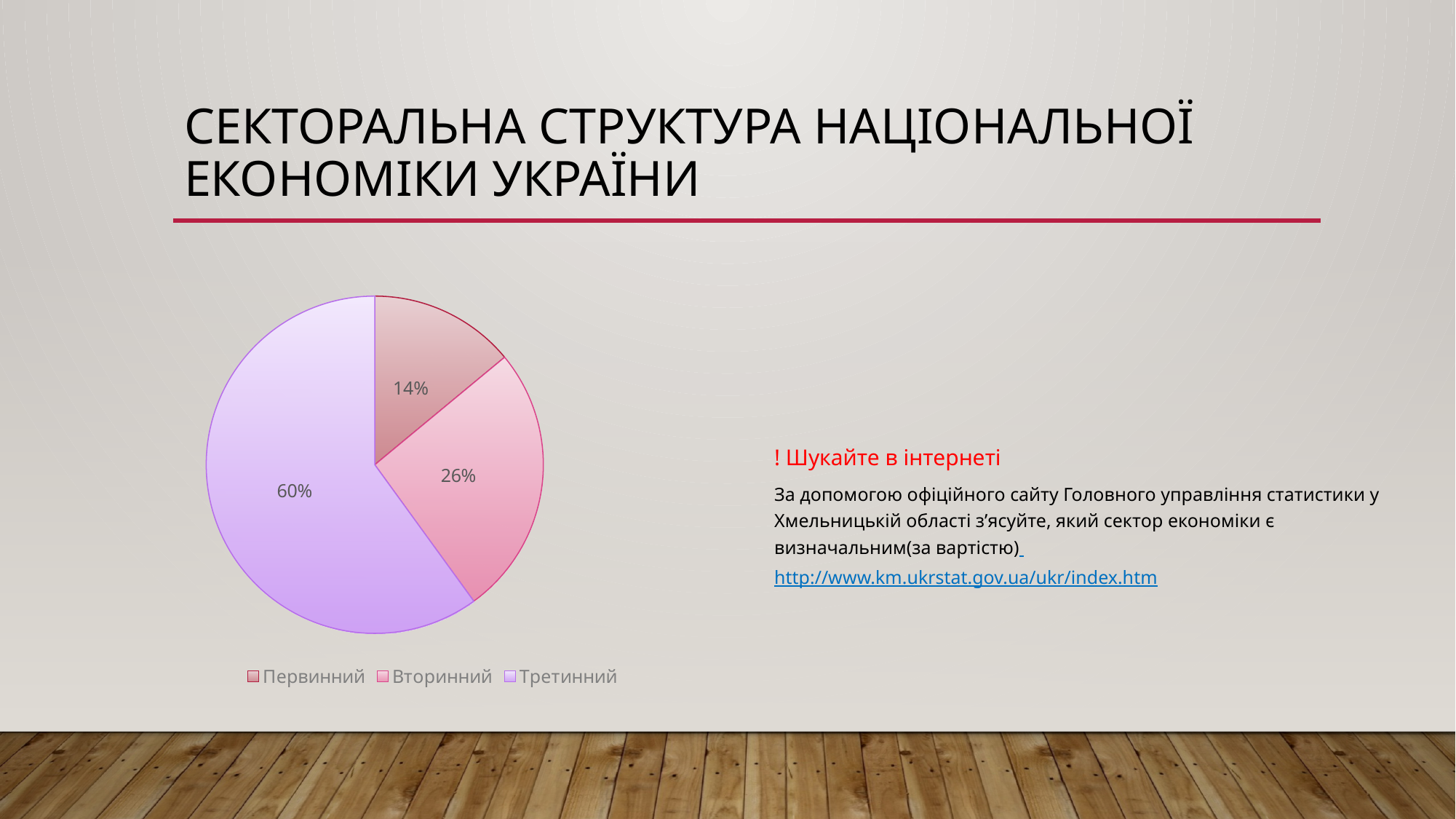
What kind of chart is shown on the slide? Pie chart Which sector has the largest slice of the pie? Третинний What is the combined share of Первинний and Вторинний? 40% What share of the pie does Вторинний have? 26% How many slices does the pie chart have? 3 Which is larger, the share of Вторинний or the share of Первинний? Вторинний What is the difference between the shares of Вторинний and Первинний? 12% What share of the pie does Первинний have? 14% Which sector has the smallest slice of the pie? Первинний What share of the pie does Третинний have? 60% What is the difference between the shares of Третинний and Вторинний? 34% Which legend entry is shown in light purple? Третинний